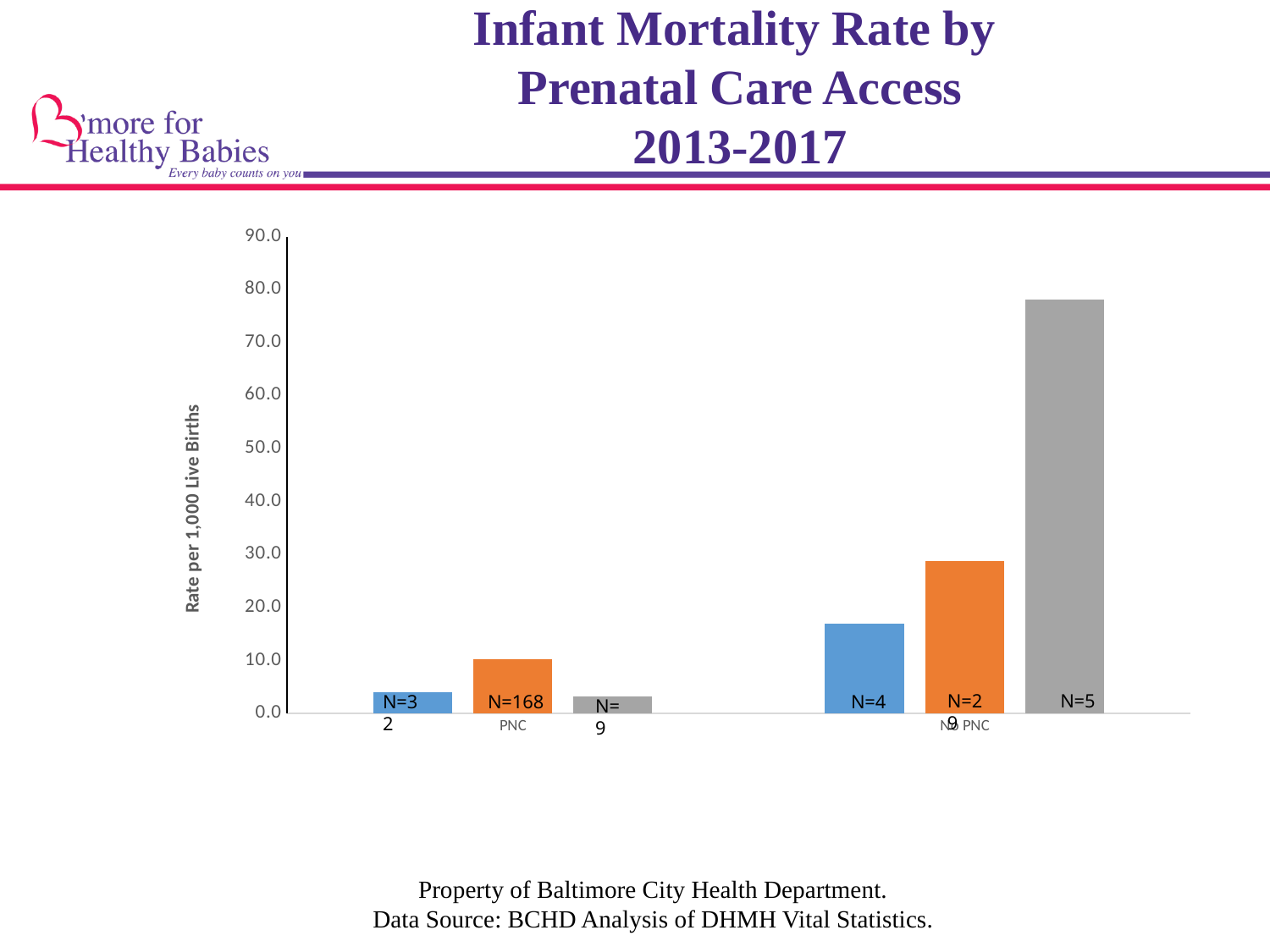
Is the value of the blue bar in the PNC group greater or less than 10? less Which is larger, the gray bar in the PNC group or the gray bar in the No PNC group? the gray bar in the No PNC group What is the label on the vertical axis of the chart? Rate per 1,000 Live Births How many bars are in the No PNC group? 3 What is the title of the chart on the slide? Infant Mortality Rate by Prenatal Care Access 2013-2017 What kind of chart is shown on the slide? bar chart Is the value of the gray bar in the No PNC group greater or less than 70? greater In the No PNC group, which is larger, the blue bar or the orange bar? the orange bar Which bar is the tallest in the chart? the gray bar in the No PNC group Is the value of the blue bar in the No PNC group greater or less than 10? greater How many category groups are shown along the x axis of the chart? 2